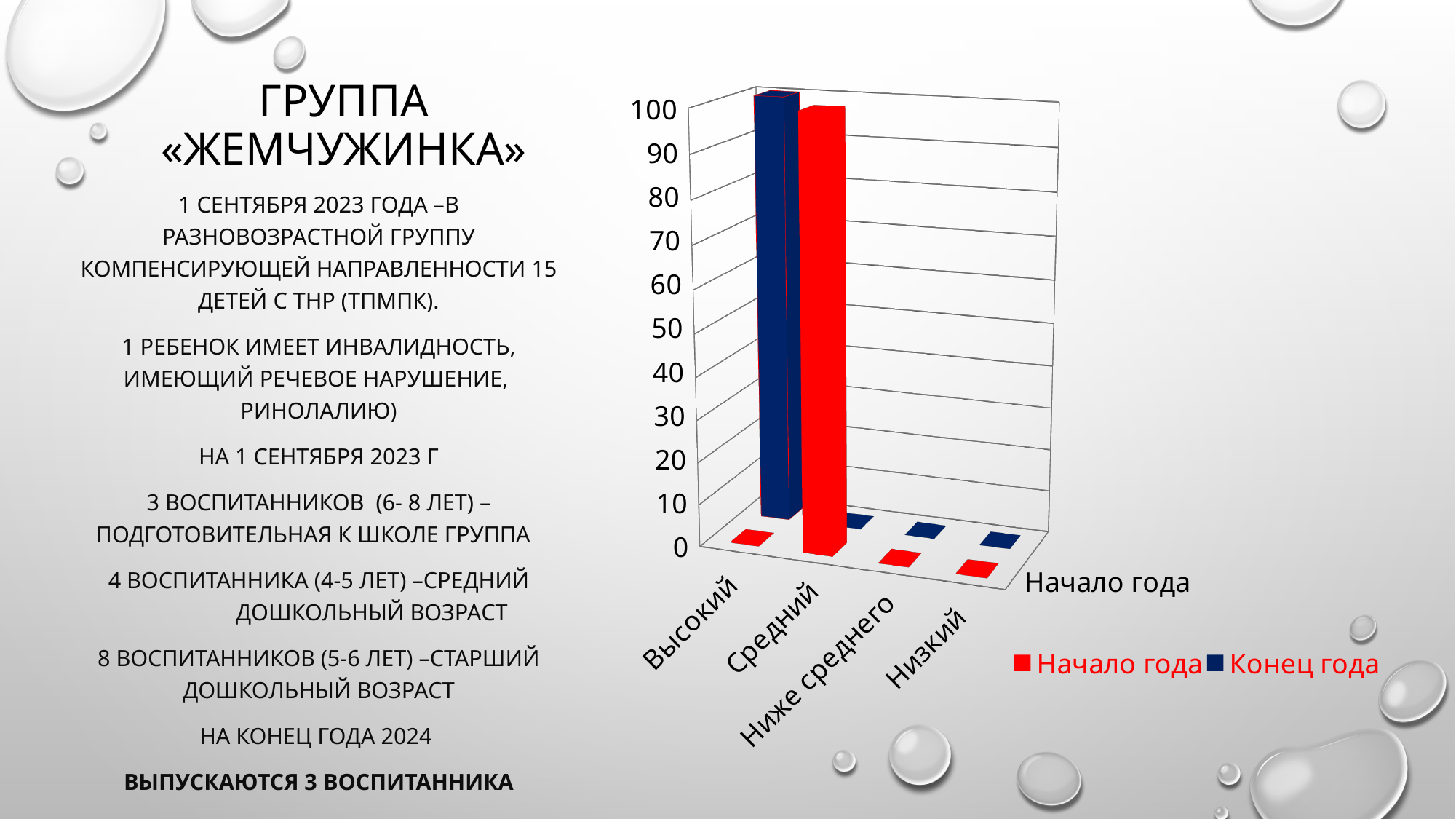
How many categories are shown on the x axis of the chart? 4 Which is larger for the series Начало года: the value for Средний or the value for Ниже среднего? Средний How many series does the chart legend list? 2 What are the two series named in the chart legend? Начало года and Конец года Which category has the highest value for the series Конец года? Высокий Is the value for Средний in the series Начало года greater or less than 50? greater Which category has the highest value for the series Начало года? Средний Is the value for Средний in the series Конец года greater or less than 90? less Which colour represents the series Конец года in the chart? dark blue Is the value for Низкий in the series Начало года greater or less than 10? less What kind of chart is shown on the slide? bar chart